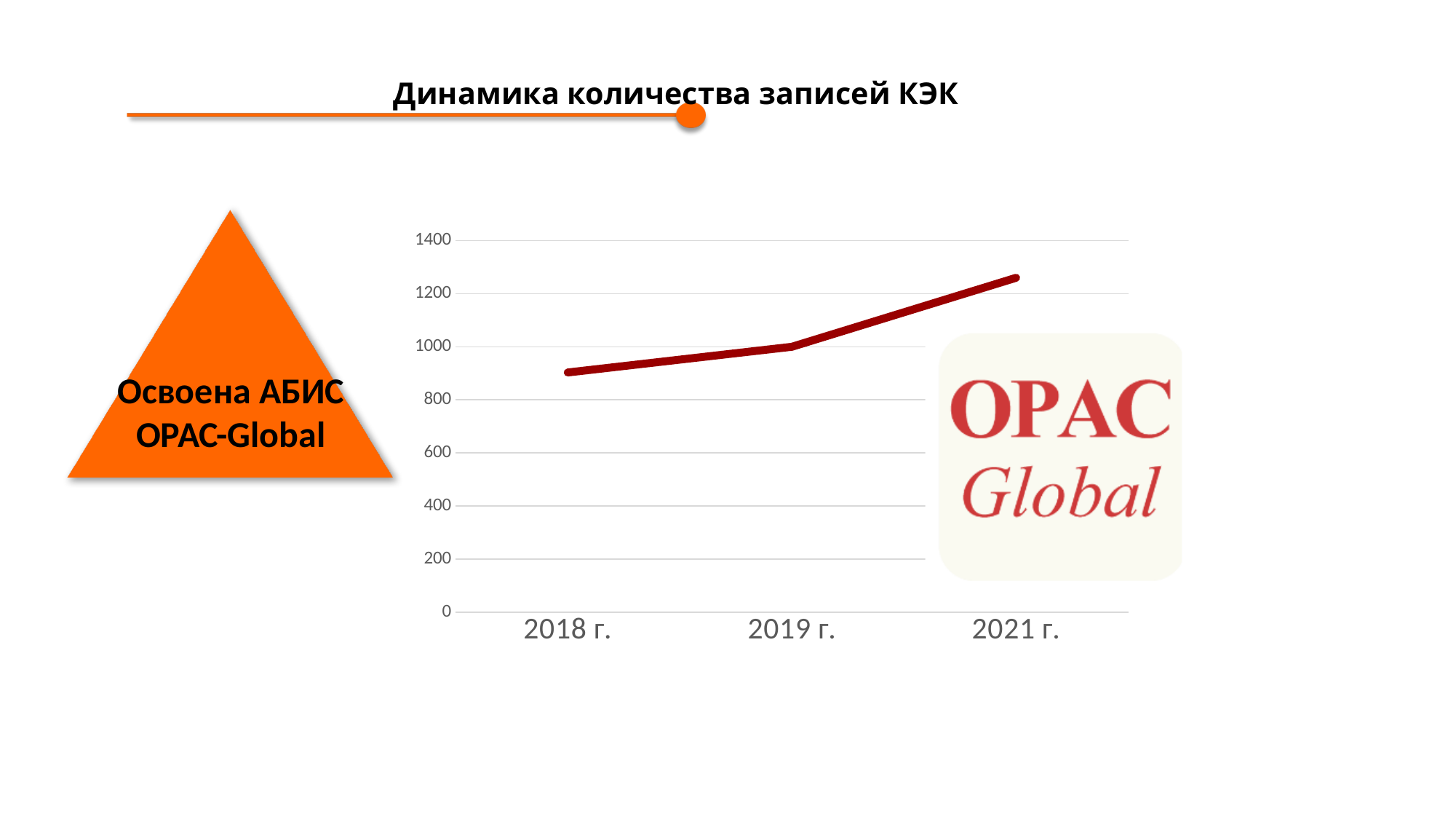
What is the highest value shown on the vertical axis of the chart? 1400 Which year has the highest value on the chart? 2021 г. Do the values rise or fall from 2018 to 2021? rise What is the title of the chart on the slide? Динамика количества записей КЭК Is the value for 2021 г. greater or less than 1400? less Is the value for 2018 г. greater or less than 1000? less How many data points are plotted on the line chart? 3 Is the value for 2018 г. greater or less than 800? greater What kind of chart is shown on the slide? line chart Which is larger, the value for 2018 г. or the value for 2021 г.? 2021 г. Which year has the lowest value on the chart? 2018 г.